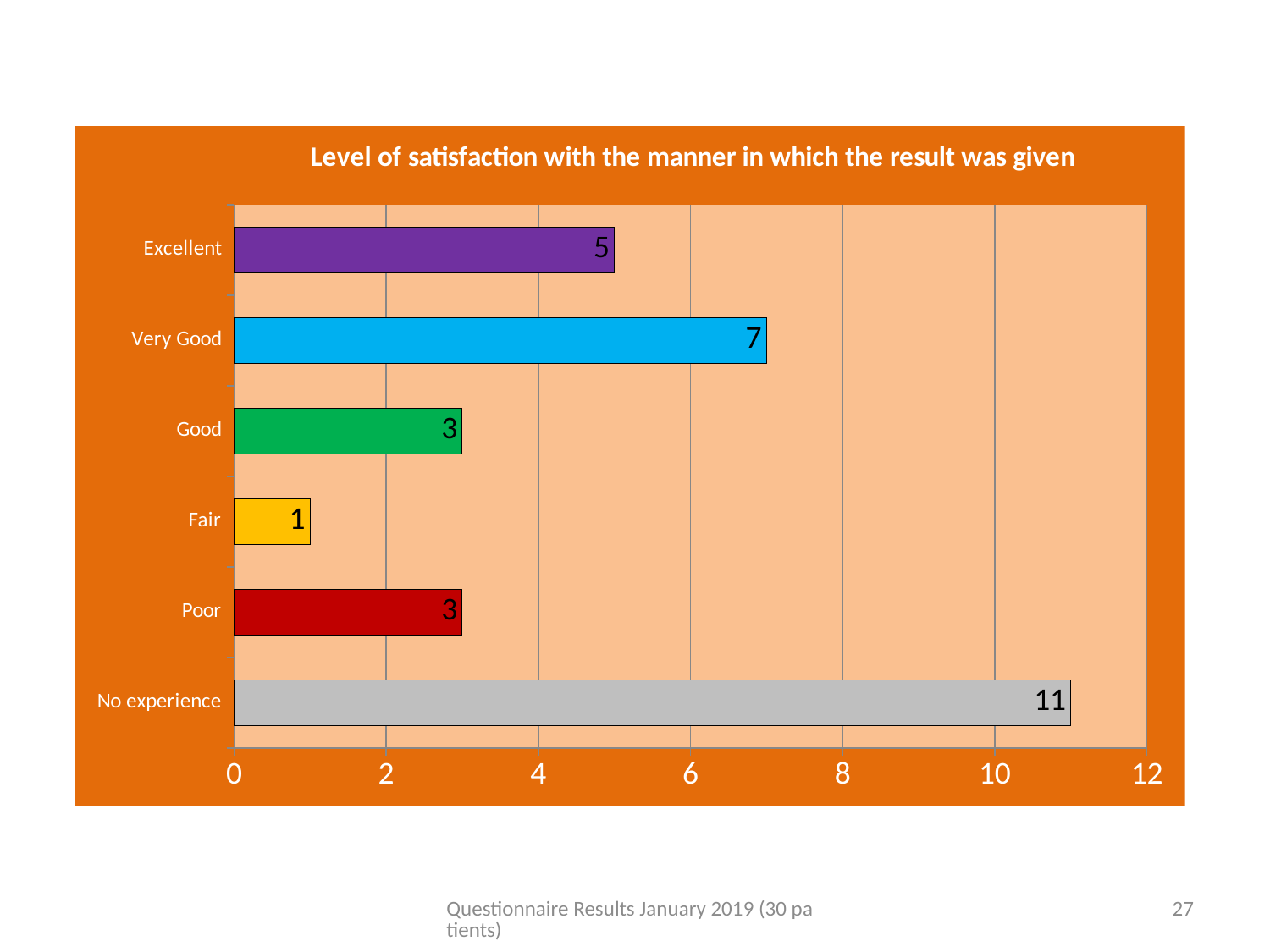
How many categories are shown in the chart? 6 Which is larger, the value for Excellent or the value for Good? Excellent What is the value for No experience? 11 Which category has the lowest value? Fair What colour is the bar for Poor? red What is the value for Very Good? 7 Is the value for No experience greater or less than 10? greater Which category has the highest value? No experience What kind of chart is shown on the slide? bar chart What is the value for Fair? 1 What is the title of the chart? Level of satisfaction with the manner in which the result was given What is the difference between the values for Very Good and Excellent? 2